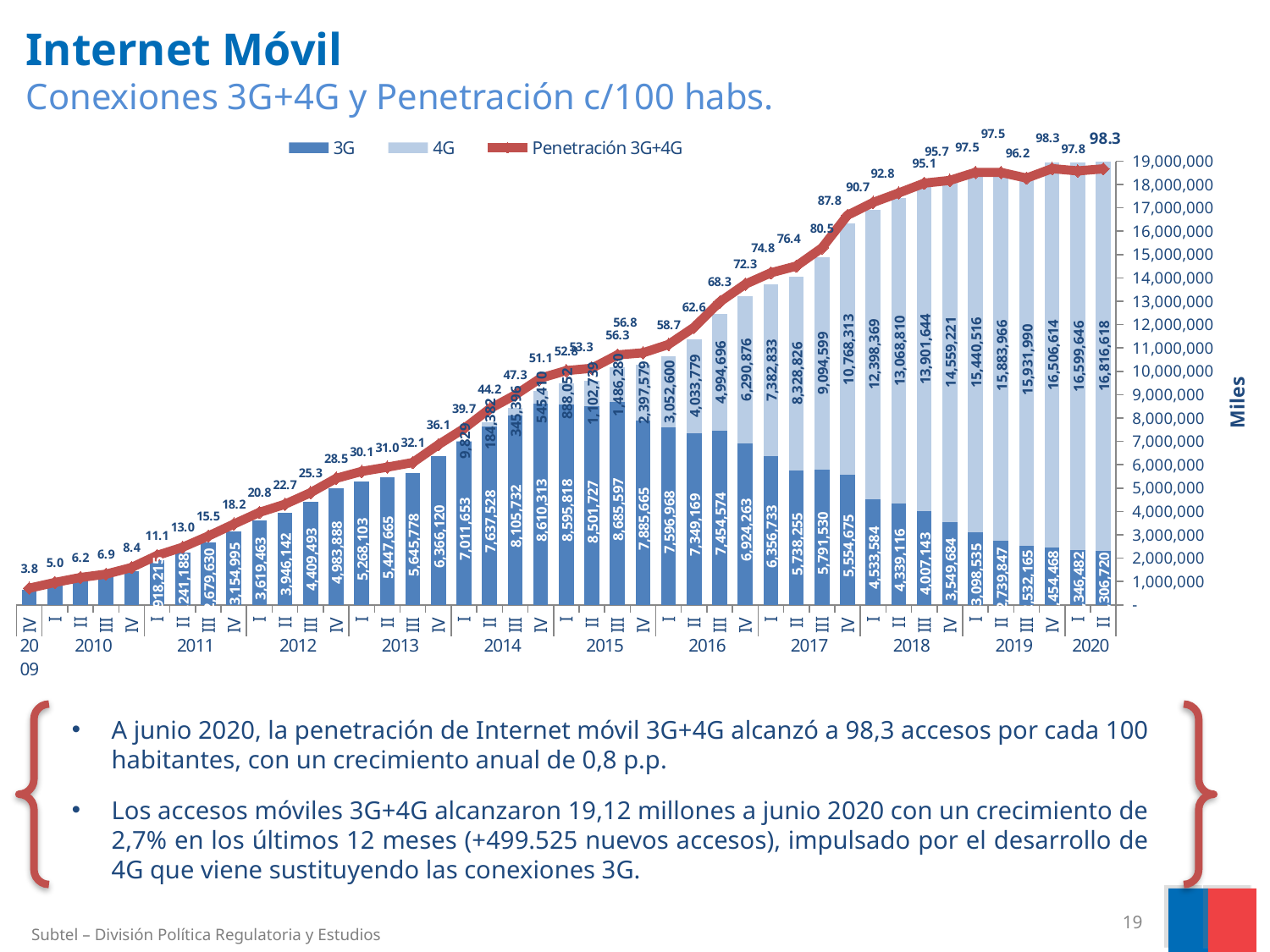
What is the Penetración 3G+4G value for the fourth quarter (IV) of 2009? 3.8 What is the Penetración 3G+4G value for the second quarter (II) of 2020? 98.3 What kind of chart is shown on the slide? A stacked bar chart combined with a line chart How many series does the legend list? 3 What is the 4G value for the fourth quarter (IV) of 2018? 14,559,221 What is the 3G value for the second quarter (II) of 2020? 2,306,720 In the second quarter (II) of 2020, which is larger, the 3G value or the 4G value? 4G What is the 4G value for the second quarter (II) of 2020? 16,816,618 In which quarter does the 3G series reach its highest value? III 2015 (8,685,597) By how much did Penetración 3G+4G change between II 2019 and II 2020? 0.8 Does the Penetración 3G+4G line generally rise or fall from 2009 to 2020? Rise What is the total of the stacked bar (3G + 4G) for the second quarter (II) of 2020? 19,123,338